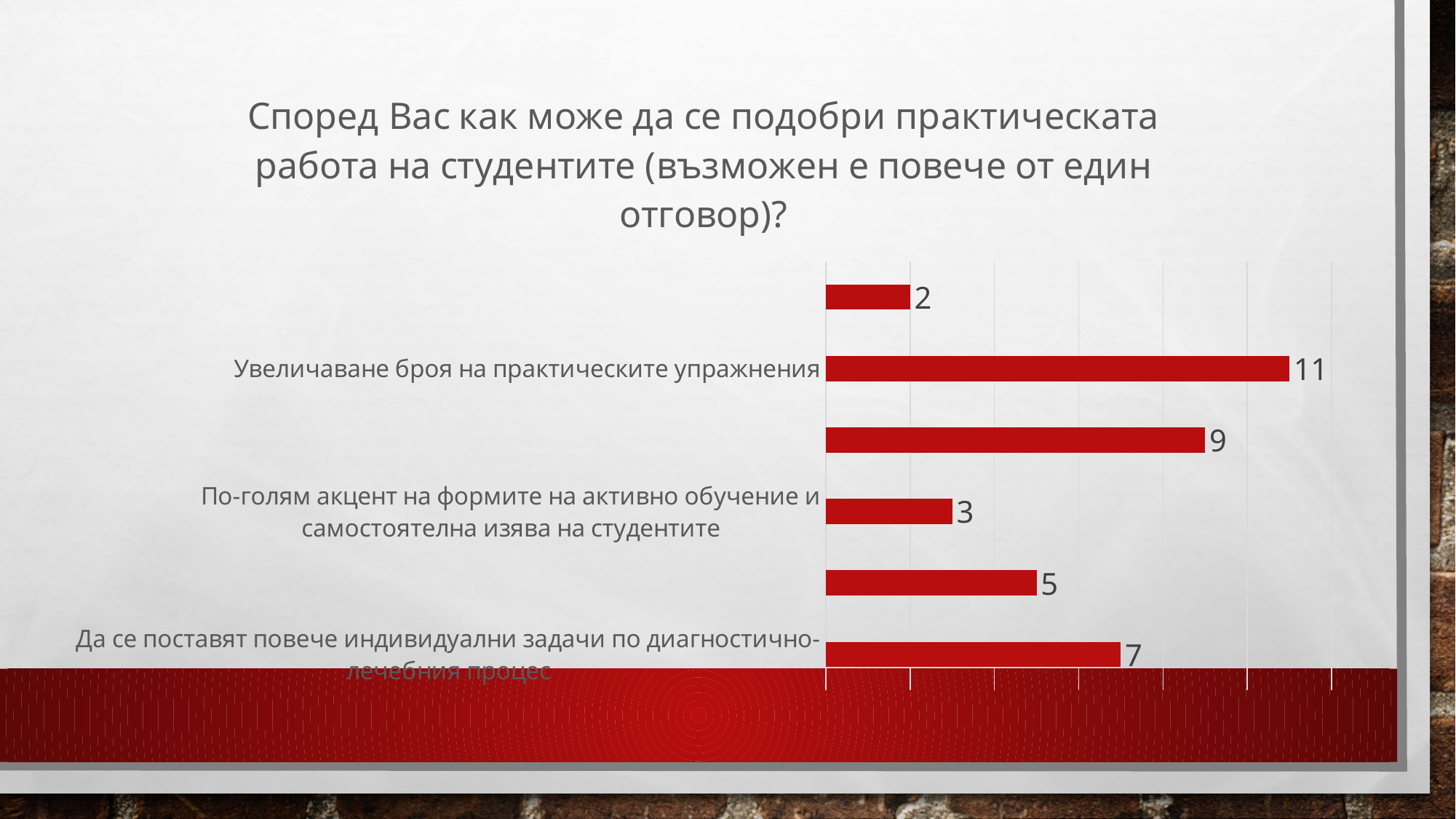
What is the value for "По-голям акцент на формите на активно обучение и самостоятелна изява на студентите"? 3 What type of chart is shown on the slide? bar chart What colour are the bars in the chart? red Which is larger: the value for "Да се поставят повече индивидуални задачи по диагностично-лечебния процес" or the value for "По-голям акцент на формите на активно обучение и самостоятелна изява на студентите"? Да се поставят повече индивидуални задачи по диагностично-лечебния процес What is the difference between the values for "Да се поставят повече индивидуални задачи по диагностично-лечебния процес" and "По-голям акцент на формите на активно обучение и самостоятелна изява на студентите"? 4 What is the value for "Да се поставят повече индивидуални задачи по диагностично-лечебния процес"? 7 What is the value for "Увеличаване броя на практическите упражнения"? 11 What is the lowest value shown in the chart? 2 Which category has the highest value in the chart? Увеличаване броя на практическите упражнения What is the highest value shown in the chart? 11 What is the difference between the values for "Увеличаване броя на практическите упражнения" and "Да се поставят повече индивидуални задачи по диагностично-лечебния процес"? 4 How many bars are plotted in the chart? 6